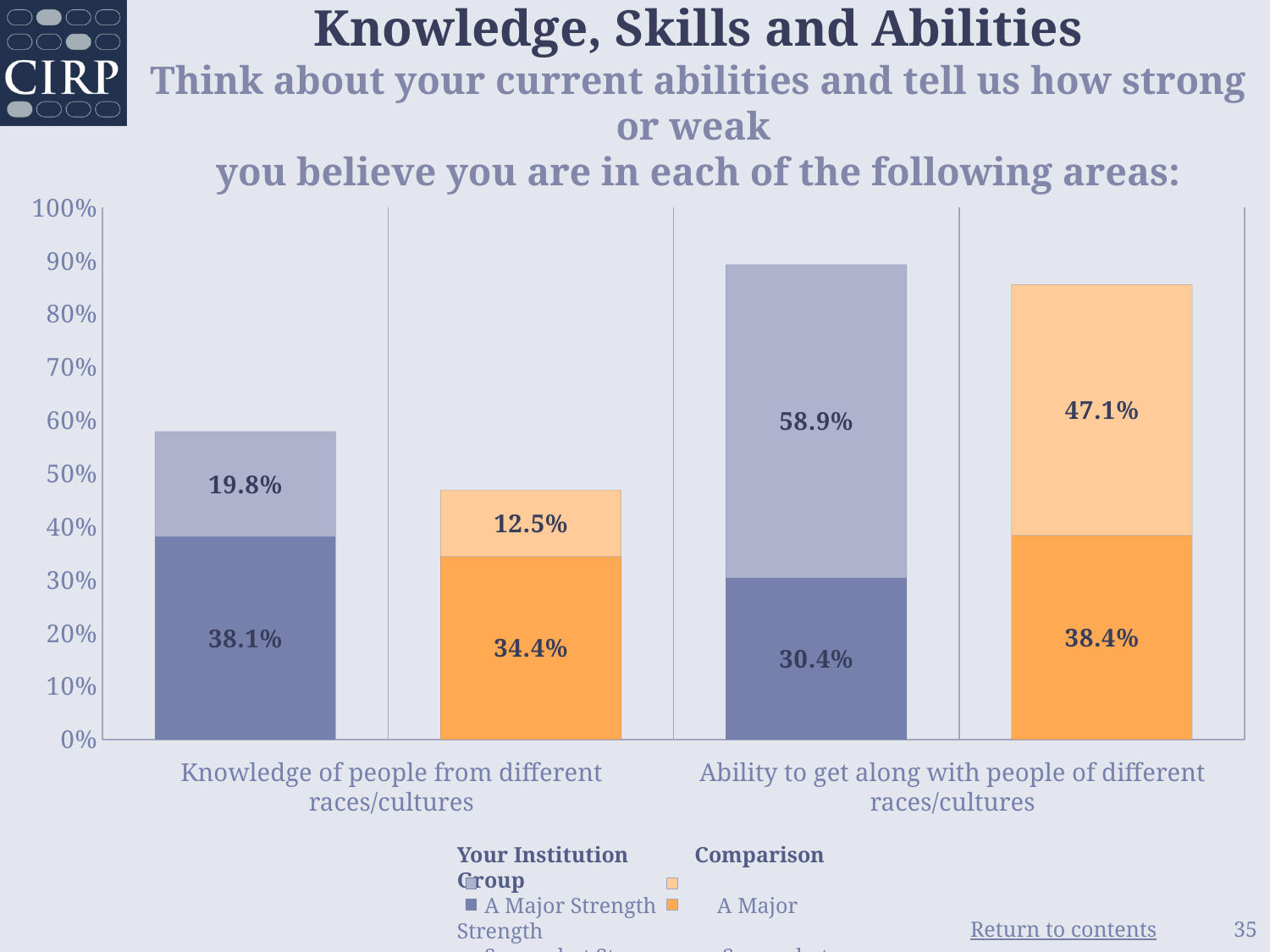
What is the difference between the 'A Major Strength' values for Your Institution and the Comparison Group for 'Knowledge of people from different races/cultures'? 3.7% What type of chart is shown on the slide? stacked bar chart What is the total height of the Comparison Group stacked bar for 'Ability to get along with people of different races/cultures'? 85.5% What is the value of the upper (lighter) segment of the Your Institution bar for 'Ability to get along with people of different races/cultures'? 58.9% What is the value of the upper (lighter) segment of the Comparison Group bar for 'Knowledge of people from different races/cultures'? 12.5% Which is larger for 'Ability to get along with people of different races/cultures': the 'A Major Strength' value for Your Institution or for the Comparison Group? Comparison Group What is the 'A Major Strength' value for Your Institution for 'Knowledge of people from different races/cultures'? 38.1% Which group's bars are shown in orange? Comparison Group What is the total height of the Your Institution stacked bar for 'Knowledge of people from different races/cultures'? 57.9% How many categories are shown on the x axis? 2 What is the 'A Major Strength' value for the Comparison Group for 'Ability to get along with people of different races/cultures'? 38.4% Is the total height of the Your Institution bar for 'Ability to get along with people of different races/cultures' greater or less than 80%? greater